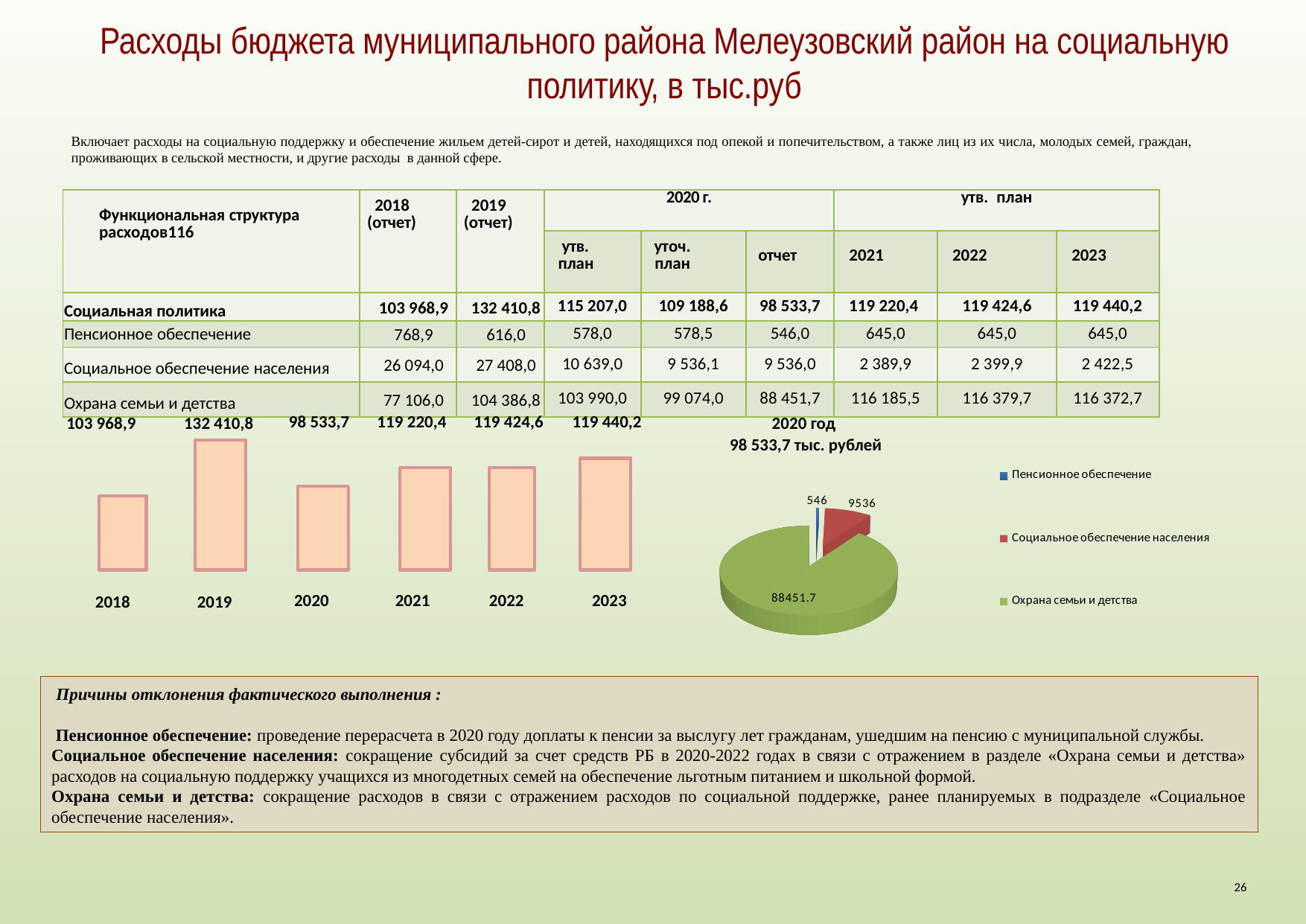
In the pie chart on the right, what is the value for Пенсионное обеспечение? 546 What kind of chart is the chart on the left? bar chart In the bar chart on the left, what is the value for 2020? 98 533,7 In the bar chart on the left, what is the value for 2019? 132 410,8 In the bar chart on the left, how many years are shown? 6 In the bar chart on the left, which year has the highest value? 2019 In the pie chart on the right, what is the value for Охрана семьи и детства? 88451.7 In the pie chart on the right, which category has the largest slice? Охрана семьи и детства In the bar chart on the left, what is the difference between the values for 2019 and 2018? 28 441,9 In the bar chart on the left, which year has the lowest value? 2020 How many entries does the legend of the pie chart on the right list? 3 In the bar chart on the left, which is larger, the value for 2018 or the value for 2020? 2018